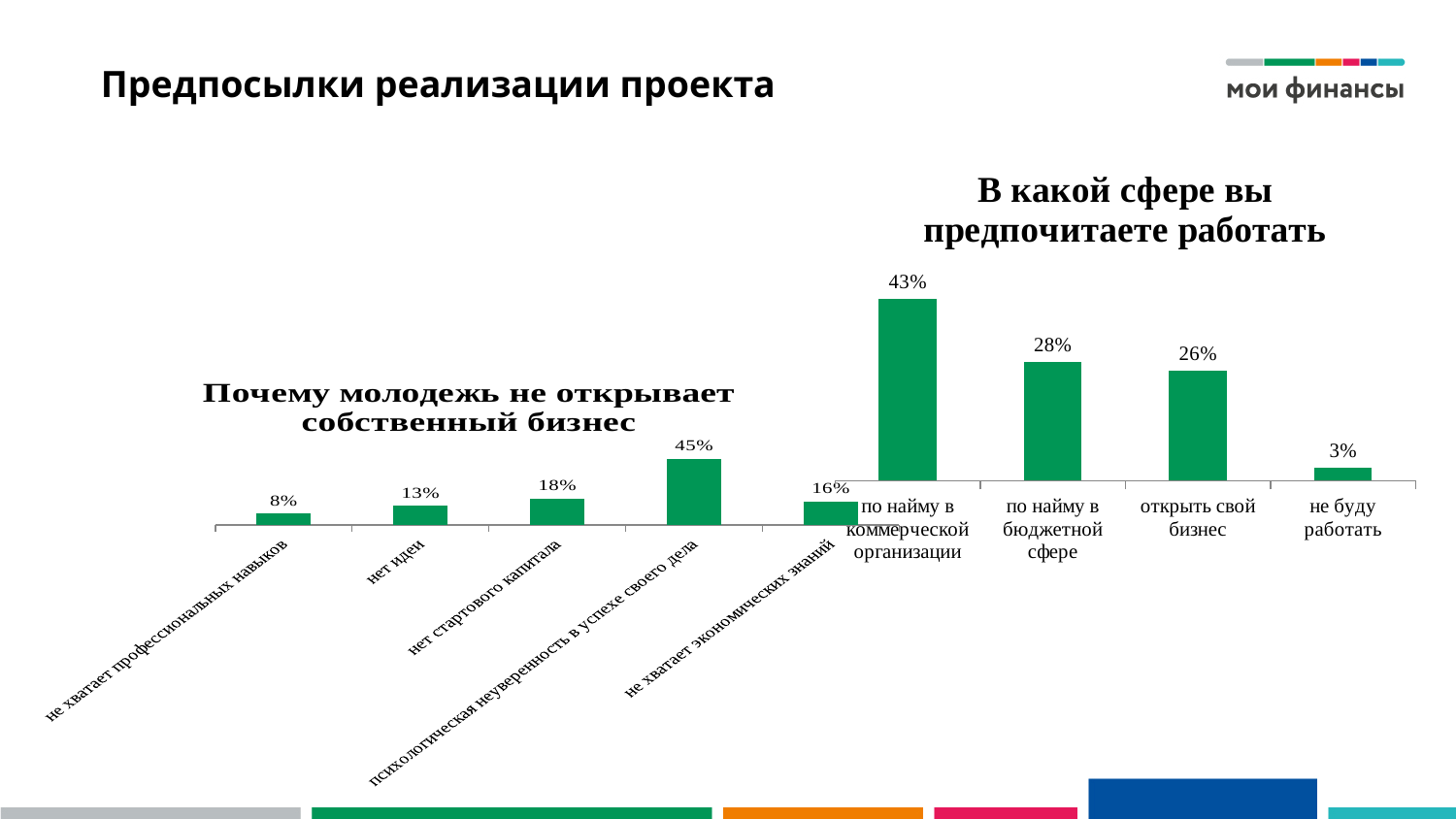
In the chart "В какой сфере вы предпочитаете работать", which is larger: "по найму в бюджетной сфере" or "не буду работать"? по найму в бюджетной сфере In the chart "В какой сфере вы предпочитаете работать", what is the value for "не буду работать"? 3% In the chart "В какой сфере вы предпочитаете работать", what is the value for "по найму в бюджетной сфере"? 28% In the chart "Почему молодежь не открывает собственный бизнес", what is the difference between "психологическая неуверенность в успехе своего дела" and "не хватает экономических знаний"? 29% In the chart "Почему молодежь не открывает собственный бизнес", what is the value for "нет идей"? 13% In the chart "Почему молодежь не открывает собственный бизнес", which category has the lowest value? не хватает профессиональных навыков In the chart "Почему молодежь не открывает собственный бизнес", what is the value for "нет стартового капитала"? 18% In the chart "Почему молодежь не открывает собственный бизнес", which category has the highest value? психологическая неуверенность в успехе своего дела In the chart "Почему молодежь не открывает собственный бизнес", how many categories are shown? 5 In the chart "В какой сфере вы предпочитаете работать", what is the difference between "по найму в коммерческой организации" and "открыть свой бизнес"? 17% In the chart "В какой сфере вы предпочитаете работать", which category has the highest value? по найму в коммерческой организации What type of chart is "В какой сфере вы предпочитаете работать"? bar chart